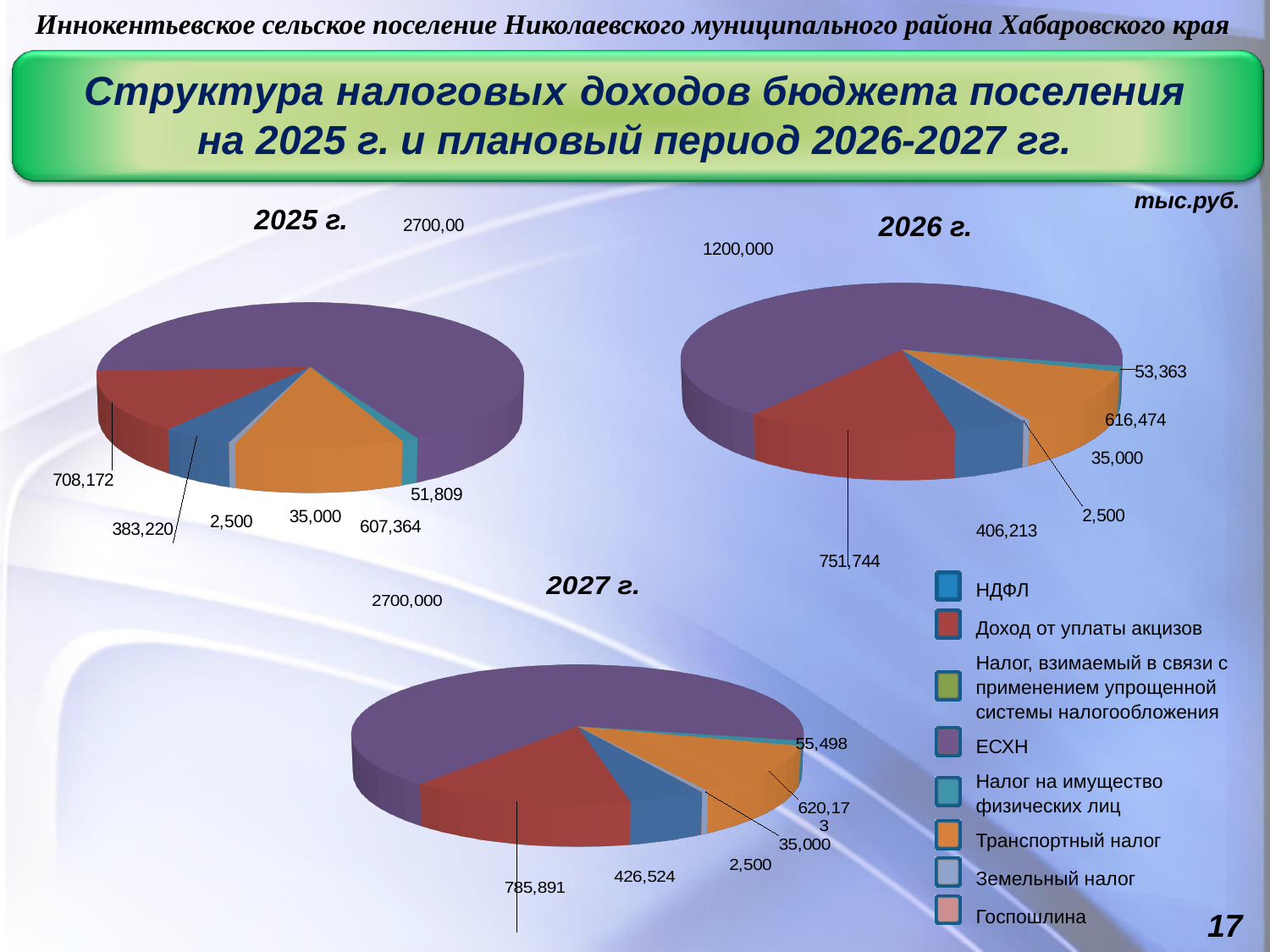
In the 2026 г. pie chart, which category has the largest slice? ЕСХН In the 2027 г. pie chart, which is larger: Доход от уплаты акцизов or НДФЛ? Доход от уплаты акцизов In the 2026 г. pie chart, what is the value for Транспортный налог (orange slice)? 616,474 What kind of charts are shown on the slide? Pie charts In the 2027 г. pie chart, what is the value for Доход от уплаты акцизов (red slice)? 785,891 In the 2025 г. pie chart, what is the value for Доход от уплаты акцизов (red slice)? 708,172 In the 2026 г. pie chart, what is the value for НДФЛ (blue slice)? 406,213 In the 2026 г. pie chart, what is the difference between Доход от уплаты акцизов (751,744) and НДФЛ (406,213)? 345,531 How many pie charts are on the slide? 3 In the 2025 г. pie chart, what is the value for ЕСХН (purple slice)? 2700,00 How many entries does the legend list? 8 In the 2027 г. pie chart, what is the value for Налог на имущество физических лиц (teal slice)? 55,498